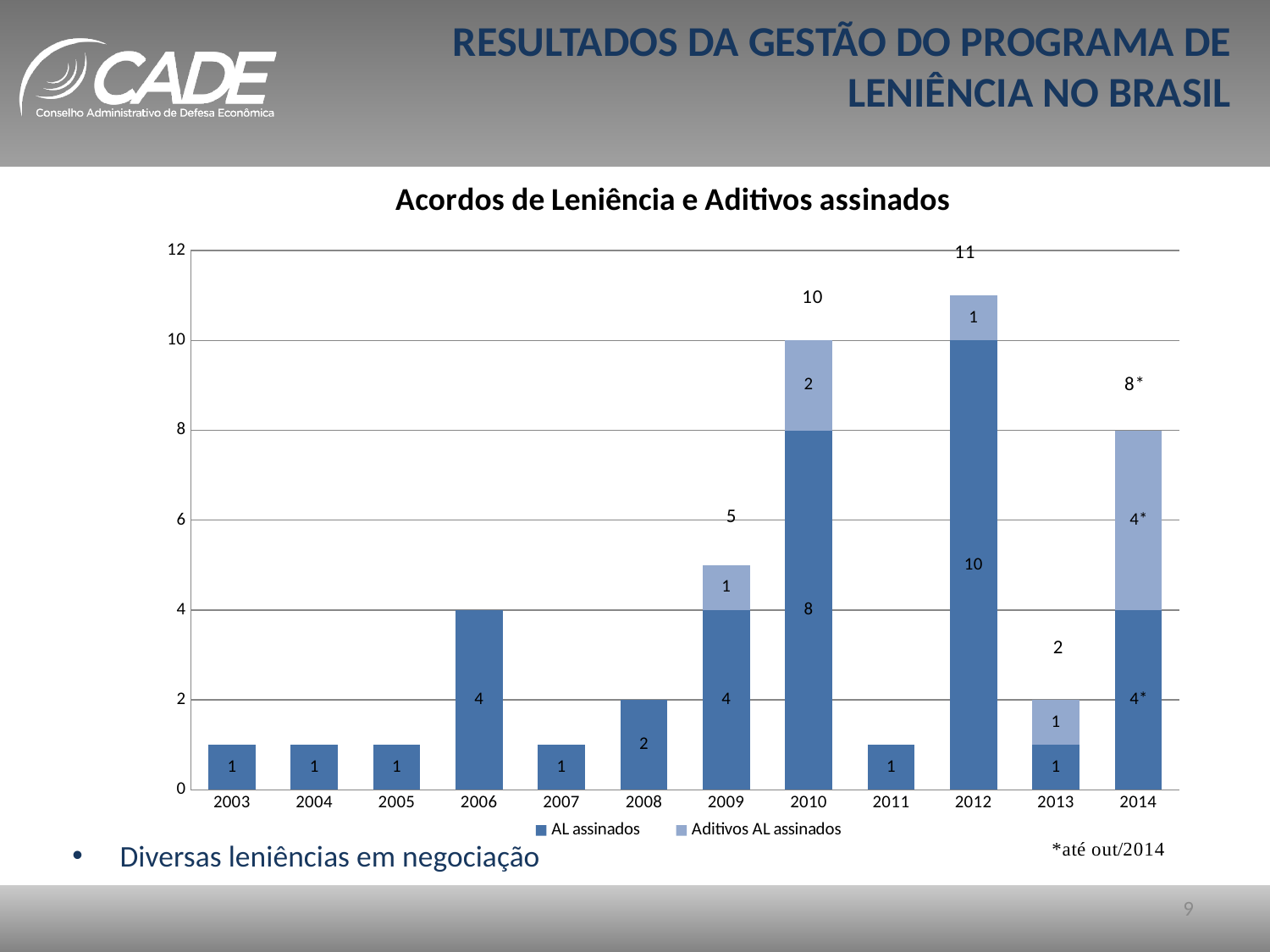
What is the value of AL assinados for 2012? 10 What is the difference between the AL assinados values for 2010 and 2006? 4 Which year has the highest total of agreements and additives signed? 2012 Which is larger, the total for 2010 or the total for 2014? 2010 What is the total of the stacked bar for 2013? 2 What is the total of the stacked bar for 2009? 5 How many years are shown on the x axis? 12 What is the value of Aditivos AL assinados for 2010? 2 What is the value of AL assinados for 2008? 2 What is the title of the chart? Acordos de Leniência e Aditivos assinados How many series does the legend list? 2 What type of chart is shown on the slide? Stacked bar chart